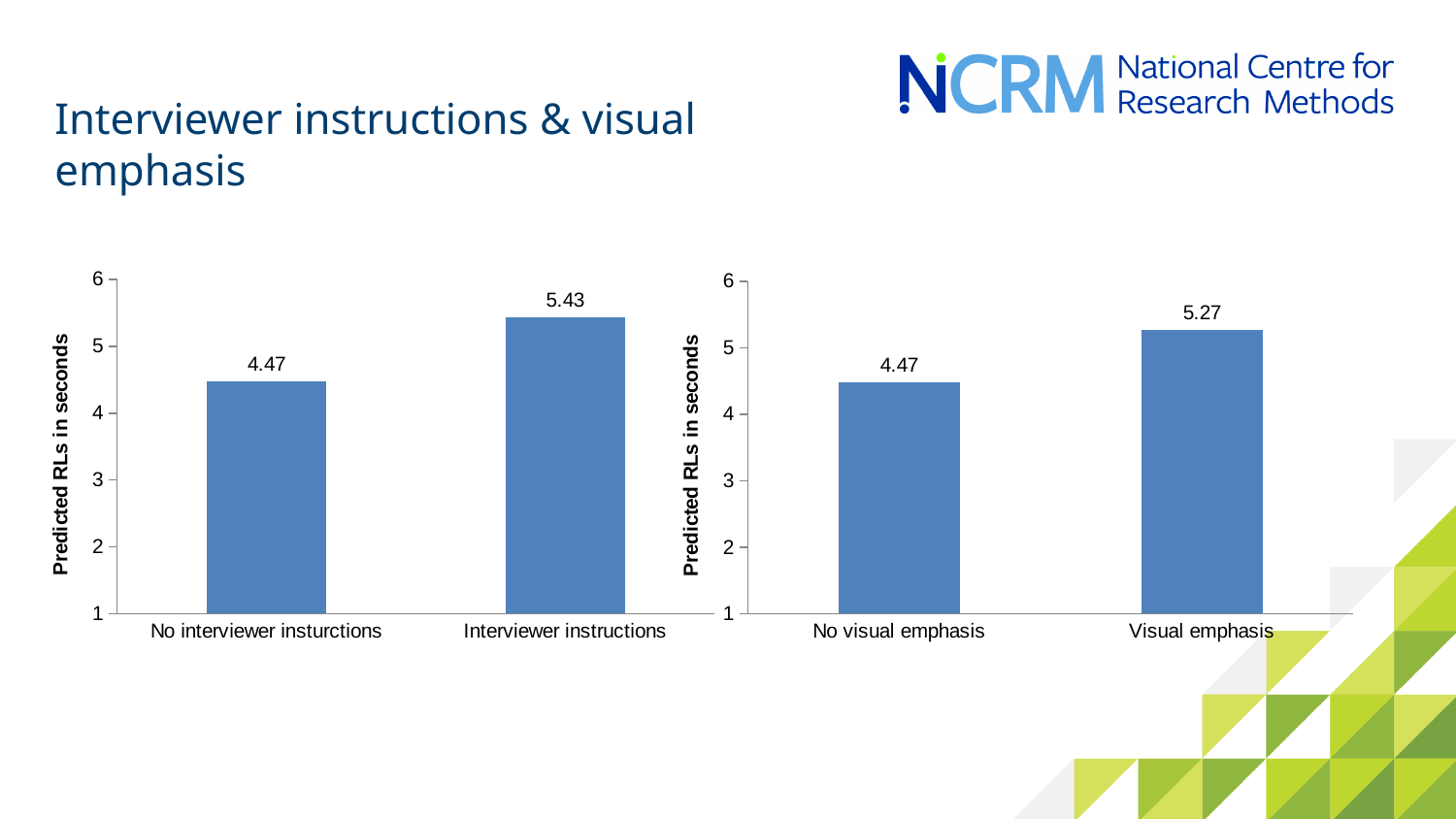
In the left chart, what is the difference between the values for 'Interviewer instructions' and 'No interviewer instructions'? 0.96 In the left chart, what is the predicted RLs in seconds for 'No interviewer instructions'? 4.47 In the right chart, what is the predicted RLs in seconds for 'No visual emphasis'? 4.47 In the left chart, what is the predicted RLs in seconds for 'Interviewer instructions'? 5.43 In the right chart, what is the difference between the values for 'Visual emphasis' and 'No visual emphasis'? 0.80 How many bars are shown in the left chart? 2 What type of chart is the right chart? Bar chart In the right chart, which category has the lower value? No visual emphasis In the right chart, what is the predicted RLs in seconds for 'Visual emphasis'? 5.27 In the right chart, is the value for 'Visual emphasis' greater or less than 5? greater Which is larger: the value for 'Interviewer instructions' in the left chart or the value for 'Visual emphasis' in the right chart? Interviewer instructions In the left chart, which category has the higher value? Interviewer instructions